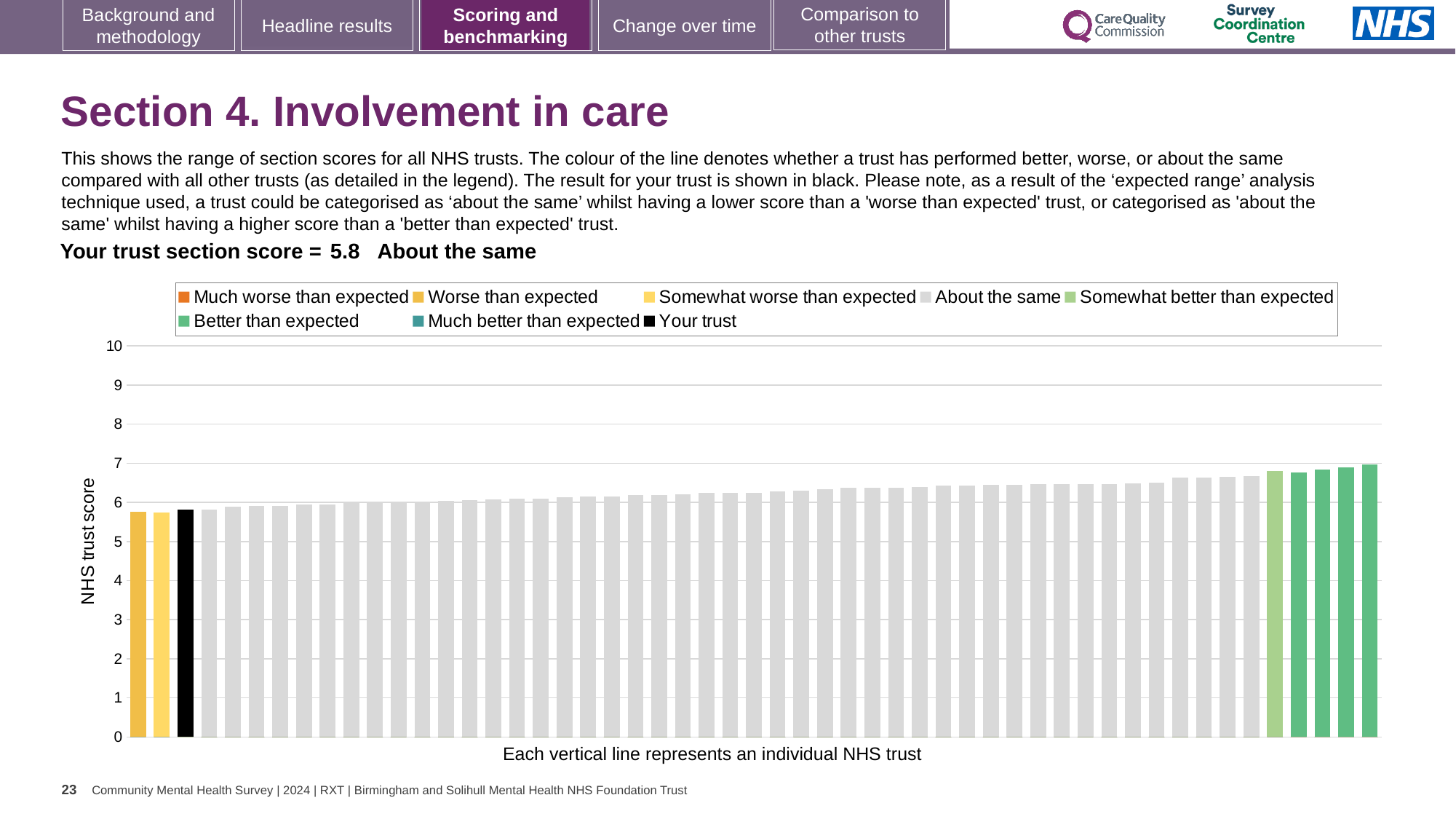
Is the value of the tallest bar greater or less than 6? greater Which bar is taller: the leftmost bar or the rightmost bar? the rightmost bar Do the bar values rise or fall from left to right along the x axis? rise What is the label on the vertical axis of the chart? NHS trust score What colour is the bar representing your trust? black What is the section score for your trust? 5.8 Which performance category is your trust placed in for this section? About the same What is the highest value shown on the vertical axis? 10 Is the value of the shortest bar greater or less than 6? less What kind of chart is shown on the slide? bar chart How many entries does the chart legend list? 8 Is your trust's section score greater or less than 5? greater